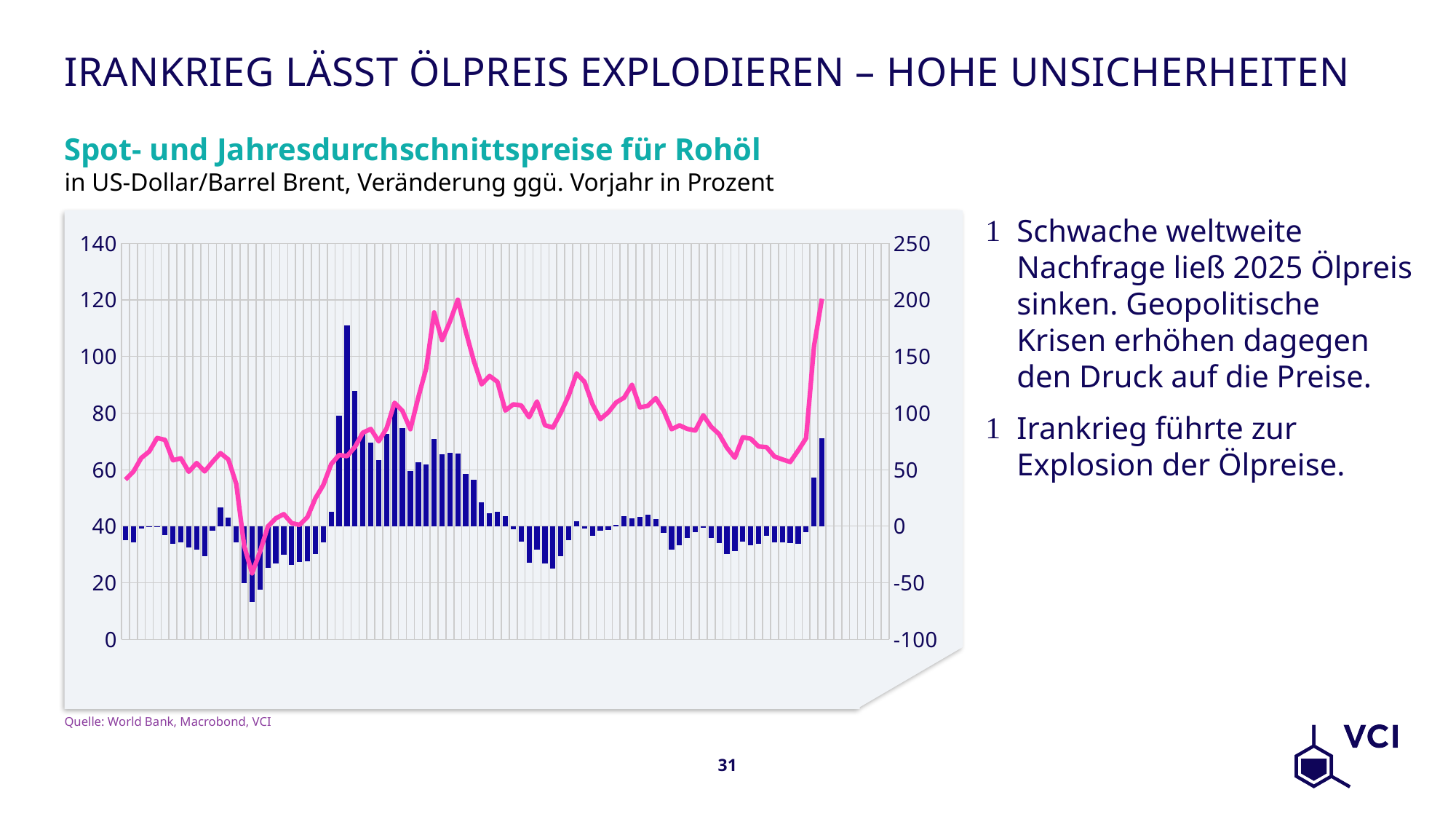
What is the title of the chart? Spot- und Jahresdurchschnittspreise für Rohöl What colour is the line series in the chart? Pink What kind of chart is shown on the slide? A combined line and bar chart Does the pink line rise or fall at the far right end of the chart? rise What is the lowest tick value shown on the right axis? -100 Is the value of the pink line at the far right end of the chart greater or less than 100? greater What is the highest tick value shown on the left axis? 140 Is the tallest blue bar greater or less than 150 on the right axis? greater Is the lowest blue bar greater or less than -50 on the right axis? less How many data series are plotted in the chart? 2